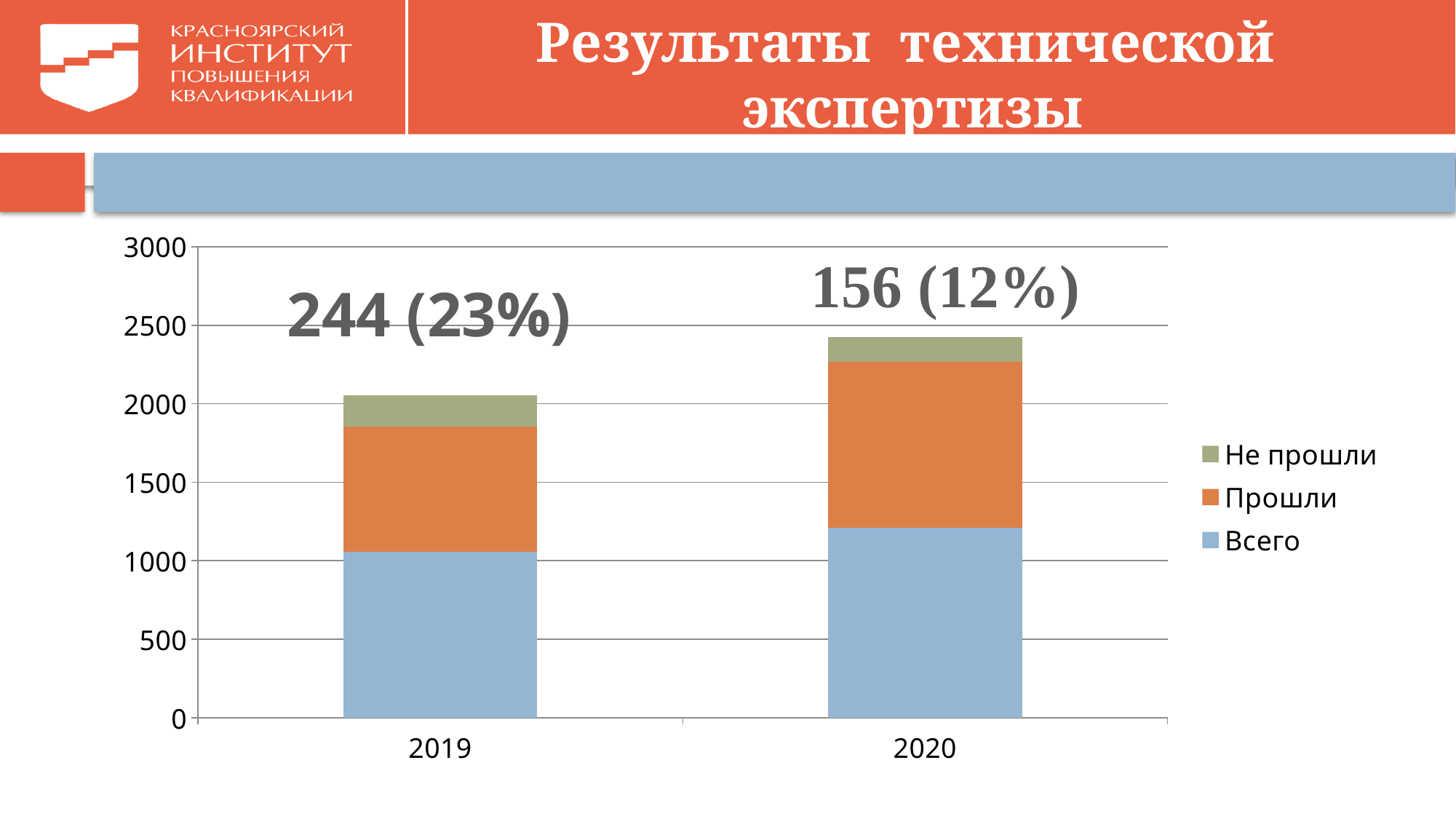
What text annotation is printed above the 2019 bar? 244 (23%) What kind of chart is shown on the slide? bar chart Which year has the highest Всего value? 2020 Which year has the taller stacked bar, 2019 or 2020? 2020 What are the entries in the chart legend? Не прошли, Прошли, Всего Is the value of the Всего segment for 2019 greater or less than 1000? greater How many categories (years) are shown on the x axis? 2 How many series does the legend list? 3 Do the stacked bar totals rise or fall from 2019 to 2020? rise Is the top of the stacked bar for 2020 greater or less than 2500? less Is the value of the Всего segment for 2020 greater or less than 1500? less